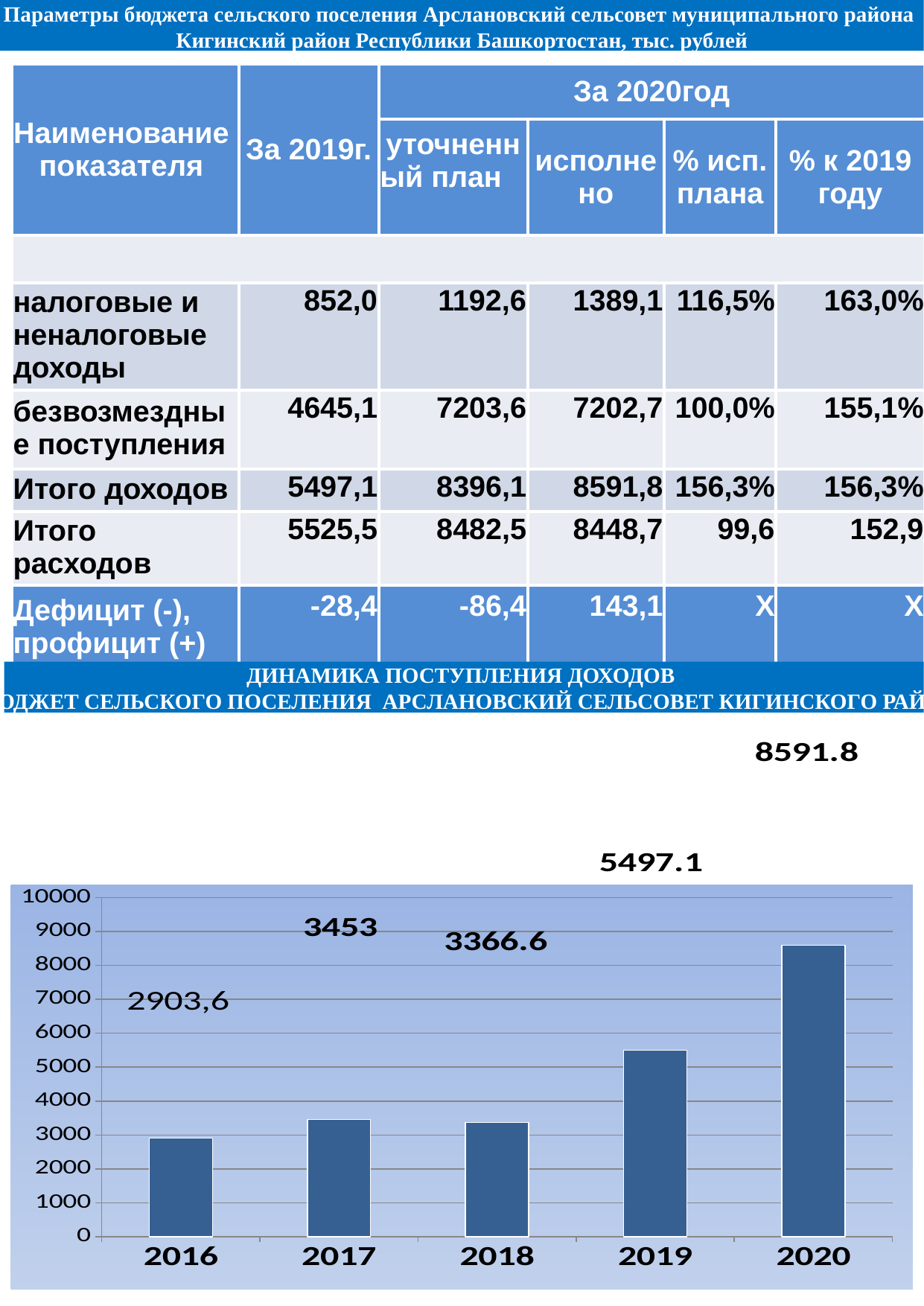
How many years are shown on the x axis of the bar chart? 5 In the bar chart, what is the value for 2020? 8591.8 In the bar chart, do the values generally rise or fall from 2016 to 2020? rise In the bar chart, what is the difference between the values for 2020 and 2019? 3094.7 In the bar chart, what is the value for 2016? 2903,6 In the bar chart, is the value for 2020 greater or less than 8000? greater In the bar chart, what is the value for 2018? 3366.6 In the bar chart, which year has the highest value? 2020 In the bar chart, what is the value for 2017? 3453 In the bar chart, which is larger: the value for 2019 or the value for 2018? 2019 What type of chart is shown under the heading 'ДИНАМИКА ПОСТУПЛЕНИЯ ДОХОДОВ'? bar chart In the bar chart, which year has the lowest value? 2016